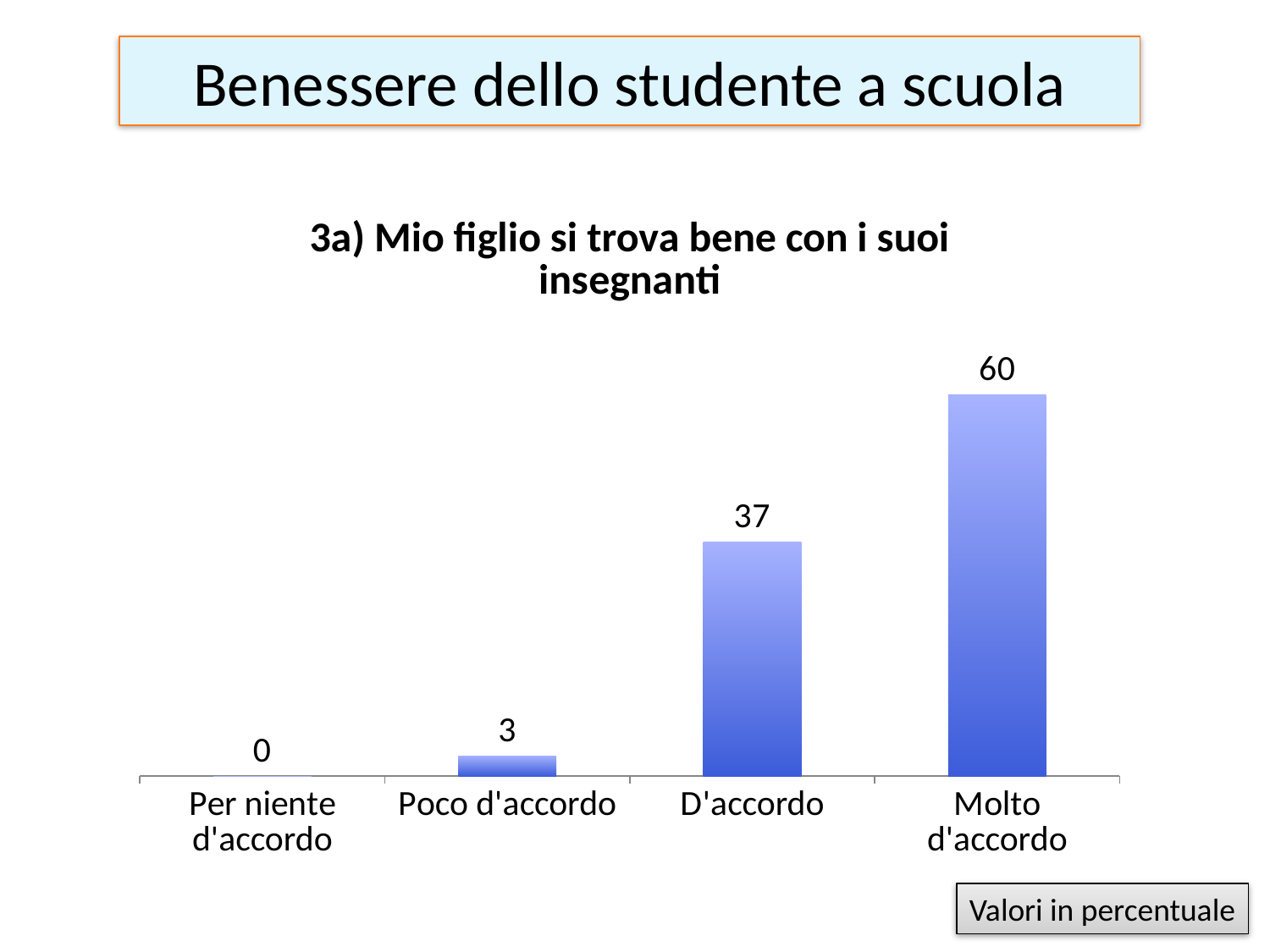
What is the value for "D'accordo"? 37 Which category has the lowest value? Per niente d'accordo What is the value for "Molto d'accordo"? 60 What is the value for "Poco d'accordo"? 3 What is the difference between the values for "D'accordo" and "Poco d'accordo"? 34 What kind of chart is shown on the slide? Bar chart Which category has the highest value? Molto d'accordo What is the value for "Per niente d'accordo"? 0 What is the difference between the values for "Molto d'accordo" and "D'accordo"? 23 What is the title of the chart? 3a) Mio figlio si trova bene con i suoi insegnanti How many categories are shown on the x axis? 4 Which is larger, the value for "D'accordo" or the value for "Poco d'accordo"? D'accordo